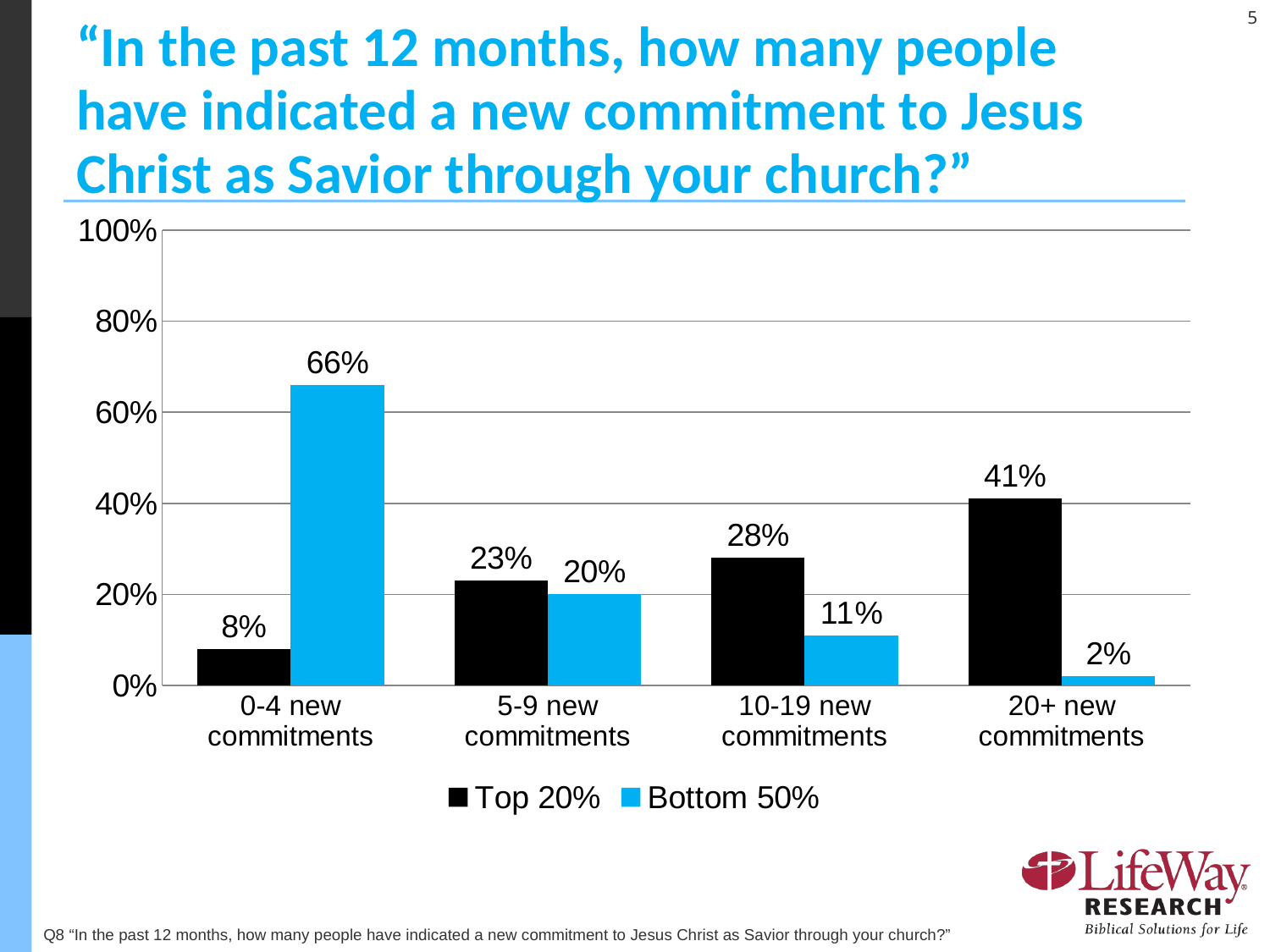
Which category has the lowest value for the Top 20% series? 0-4 new commitments In the 5-9 new commitments category, which series has the larger value, Top 20% or Bottom 50%? Top 20% What percentage of the Top 20% group reported 0-4 new commitments? 8% What percentage of the Bottom 50% group reported 0-4 new commitments? 66% How many series does the legend list? 2 What is the value for Top 20% in the 20+ new commitments category? 41% What is the value for Bottom 50% in the 10-19 new commitments category? 11% Do the Bottom 50% values rise or fall moving from 0-4 new commitments to 20+ new commitments? Fall What kind of chart is shown on the slide? Bar chart Which category has the highest value for the Bottom 50% series? 0-4 new commitments What is the difference between the Top 20% and Bottom 50% values for 20+ new commitments? 39 percentage points How many categories are shown on the x axis? 4